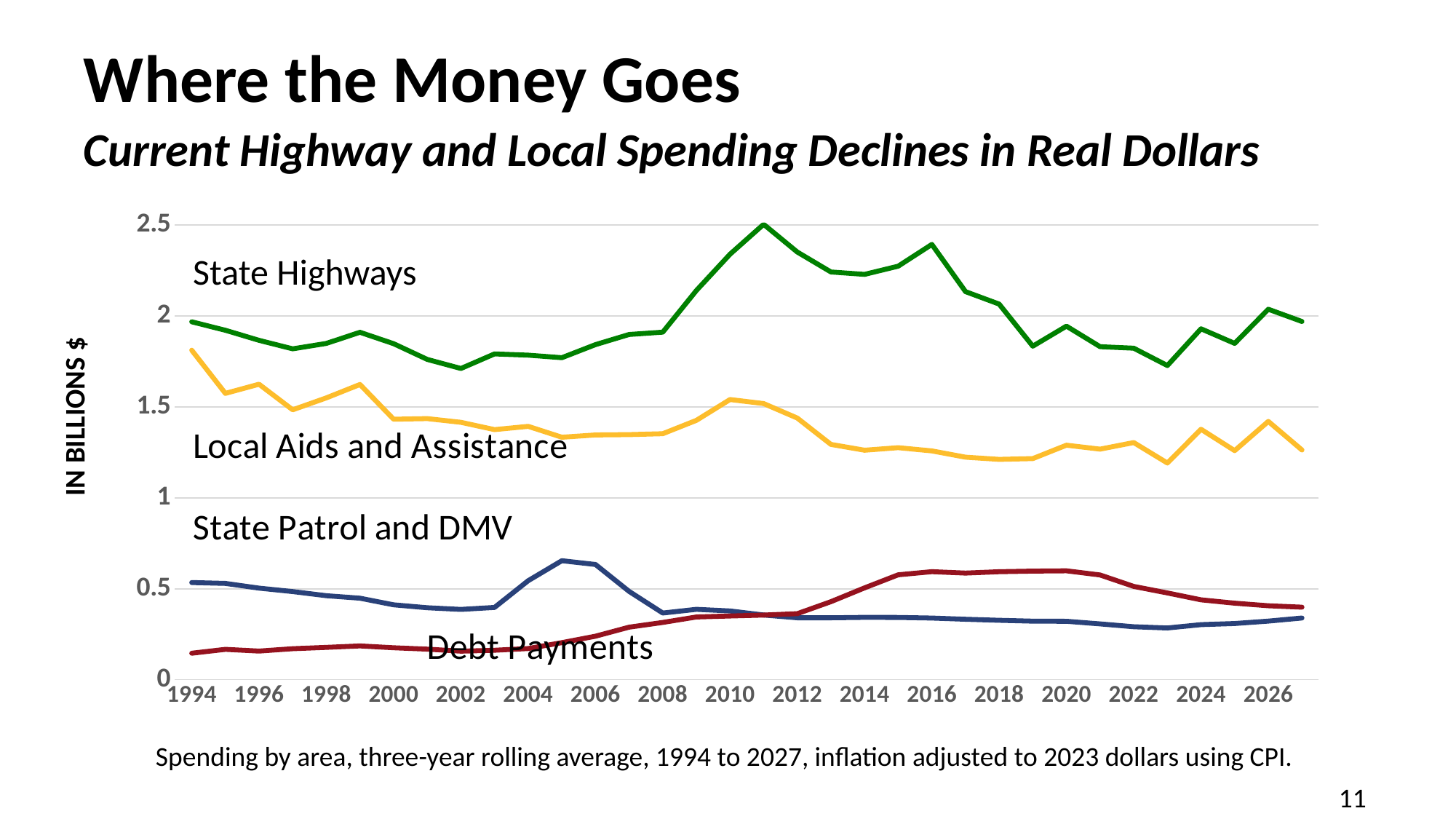
What kind of chart is shown on the slide? line chart Do Debt Payments rise or fall between 1994 and 2016? rise In 2020, which is larger: Debt Payments or State Patrol and DMV? Debt Payments Is the value for State Highways in 2011 greater or less than 2? greater What is the label on the vertical axis of the chart? IN BILLIONS $ Is the value for State Patrol and DMV in 2005 greater or less than 0.5? greater Is the value for Debt Payments in 1994 greater or less than 0.5? less Which spending series has the highest values across the whole period? State Highways In 1994, which is larger: State Patrol and DMV or Debt Payments? State Patrol and DMV Which spending series has the lowest value in 1994? Debt Payments How many spending series are plotted on the chart? 4